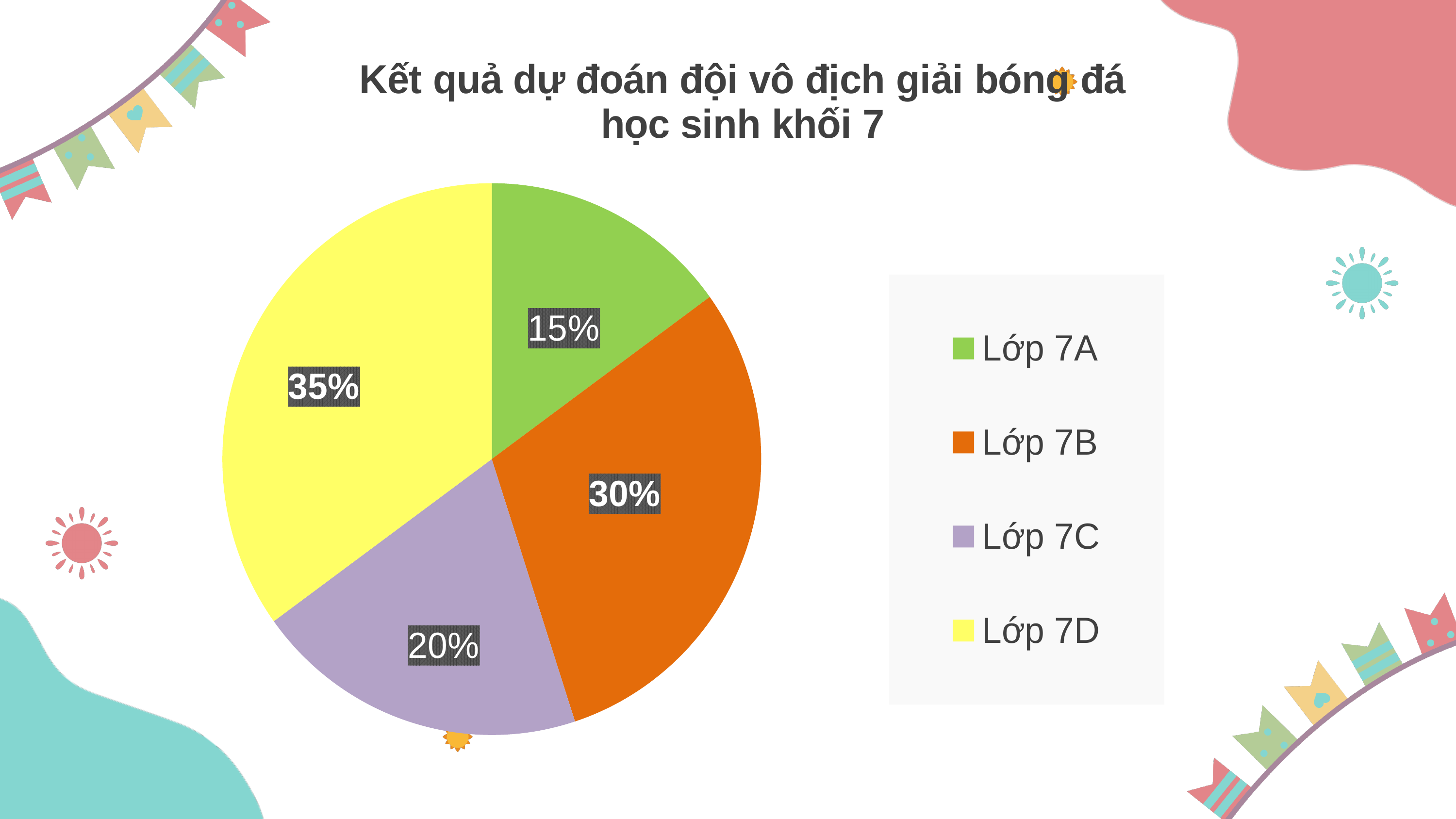
What percentage of the pie is for Lớp 7C? 20% What percentage of the pie is for Lớp 7B? 30% Which class has the largest share of the pie? Lớp 7D Which has a larger share, Lớp 7B or Lớp 7C? Lớp 7B Which class has the smallest share of the pie? Lớp 7A What colour is the slice for Lớp 7C? Purple How many slices does the pie chart have? 4 What is the title of the chart? Kết quả dự đoán đội vô địch giải bóng đá học sinh khối 7 What percentage of the pie is for Lớp 7D? 35% What percentage of the pie is for Lớp 7A? 15% What is the difference in percentage points between Lớp 7D and Lớp 7A? 20 What type of chart is shown on the slide? Pie chart